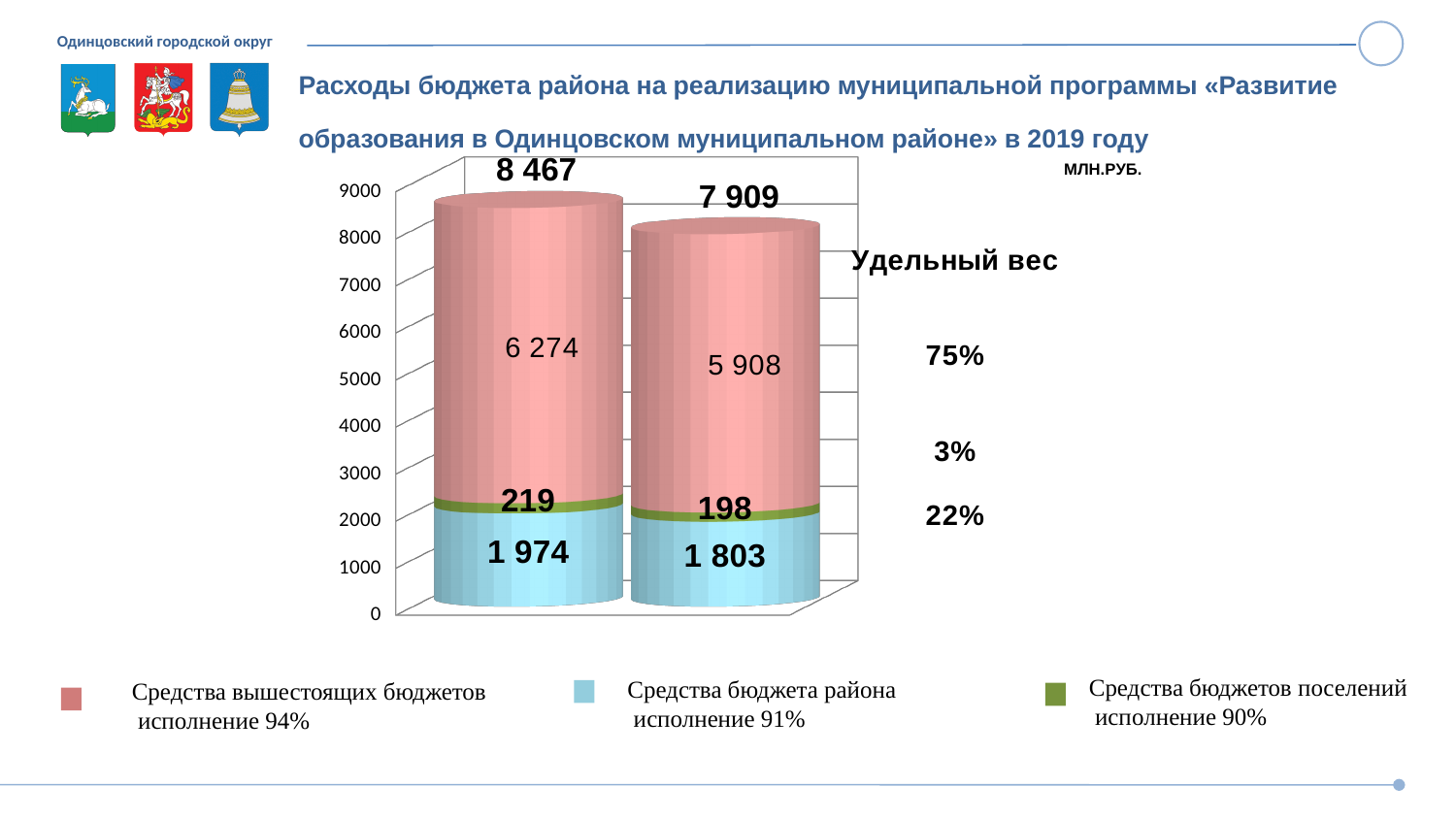
What is the total of the left stacked bar? 8 467 What kind of chart is shown on the slide? Stacked bar chart What is the value of Средства бюджетов поселений in the left bar? 219 Which bar has the larger total, the left or the right? Left How many series does the legend list? 3 What is the value of Средства бюджета района in the right bar? 1 803 In what units are the chart values given? млн.руб. How many bars are plotted in the chart? 2 What is the value of Средства вышестоящих бюджетов in the left bar? 6 274 What is the total of the right stacked bar? 7 909 What is the difference between the totals of the left bar and the right bar? 558 Which series has the smallest segment in the right bar? Средства бюджетов поселений